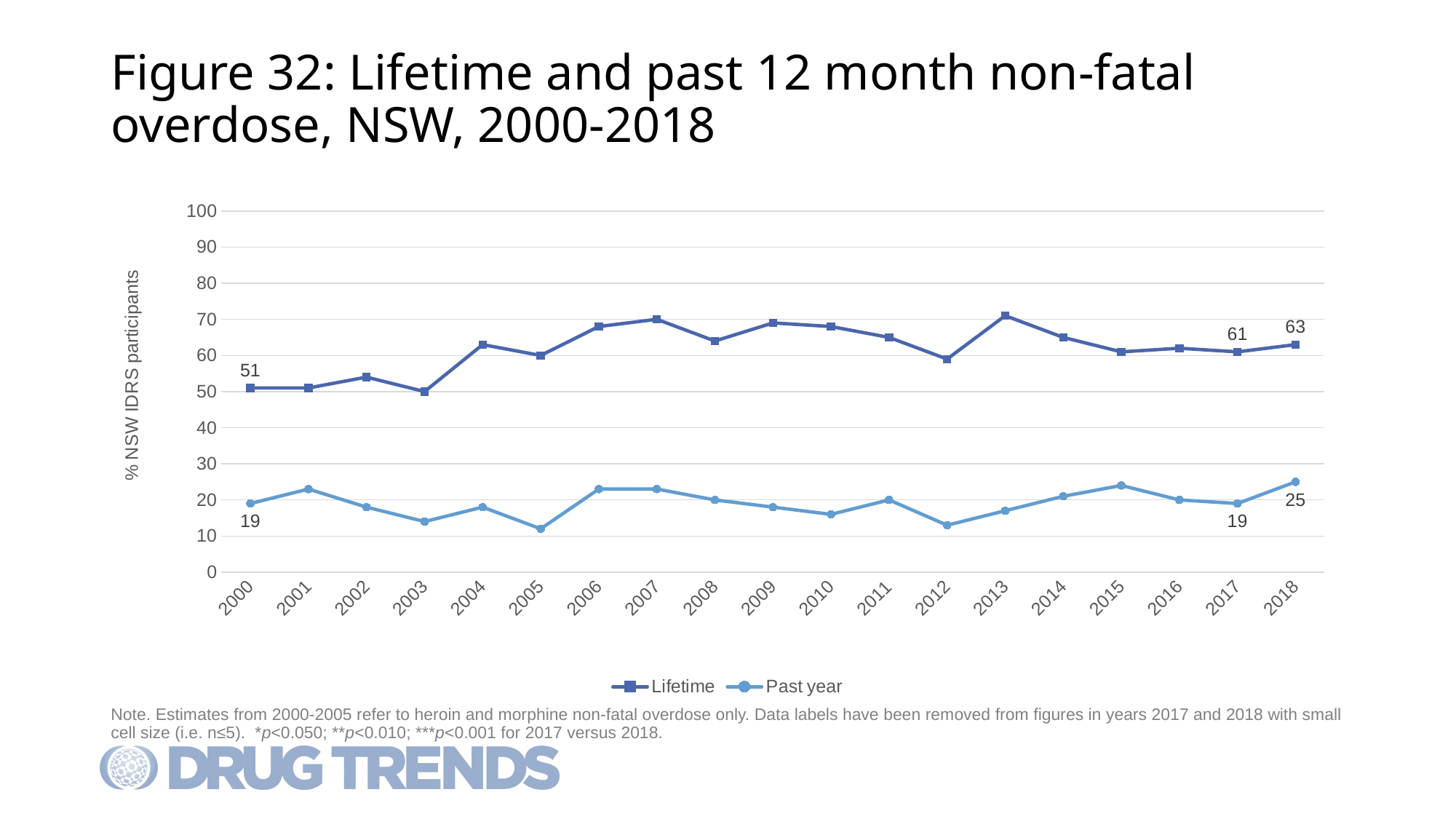
What is the label on the y axis? % NSW IDRS participants Is the Past year value for 2005 greater or less than 20? less What is the Past year value for 2017? 19 Which year has the higher Lifetime value, 2000 or 2018? 2018 What is the Lifetime value for 2018? 63 How many series does the legend list? 2 What kind of chart is shown on the slide? line chart What is the Past year value for 2018? 25 By how much did the Lifetime value change from 2017 to 2018? 2 What is the difference between the Lifetime and Past year values in 2018? 38 What is the Lifetime value for 2000? 51 How many years are shown on the x axis? 19